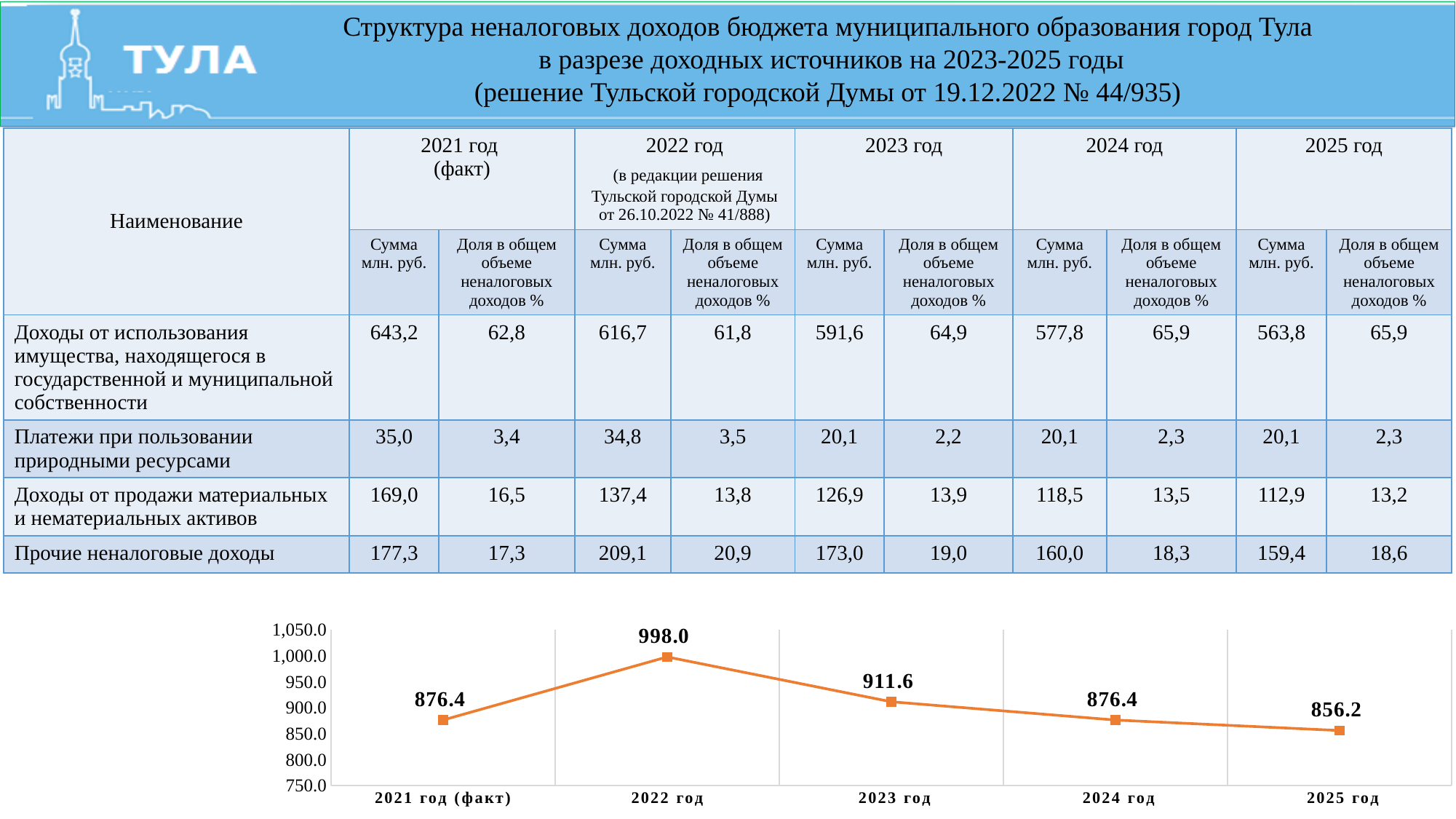
What type of chart is shown at the bottom of the slide? line chart What is the value plotted for 2023 год in the line chart? 911.6 What is the value plotted for 2025 год in the line chart? 856.2 What is the value plotted for 2022 год in the line chart? 998.0 Which year has the lowest value in the line chart? 2025 год Is the value for 2022 год in the line chart greater or less than 950.0? greater In the line chart, which is larger: the value for 2023 год or the value for 2024 год? 2023 год What is the difference between the values for 2024 год and 2025 год in the line chart? 20.2 Which year has the highest value in the line chart? 2022 год How many data points are plotted in the line chart? 5 How do the values in the line chart change from 2022 год to 2025 год? they fall What is the difference between the values for 2022 год and 2023 год in the line chart? 86.4